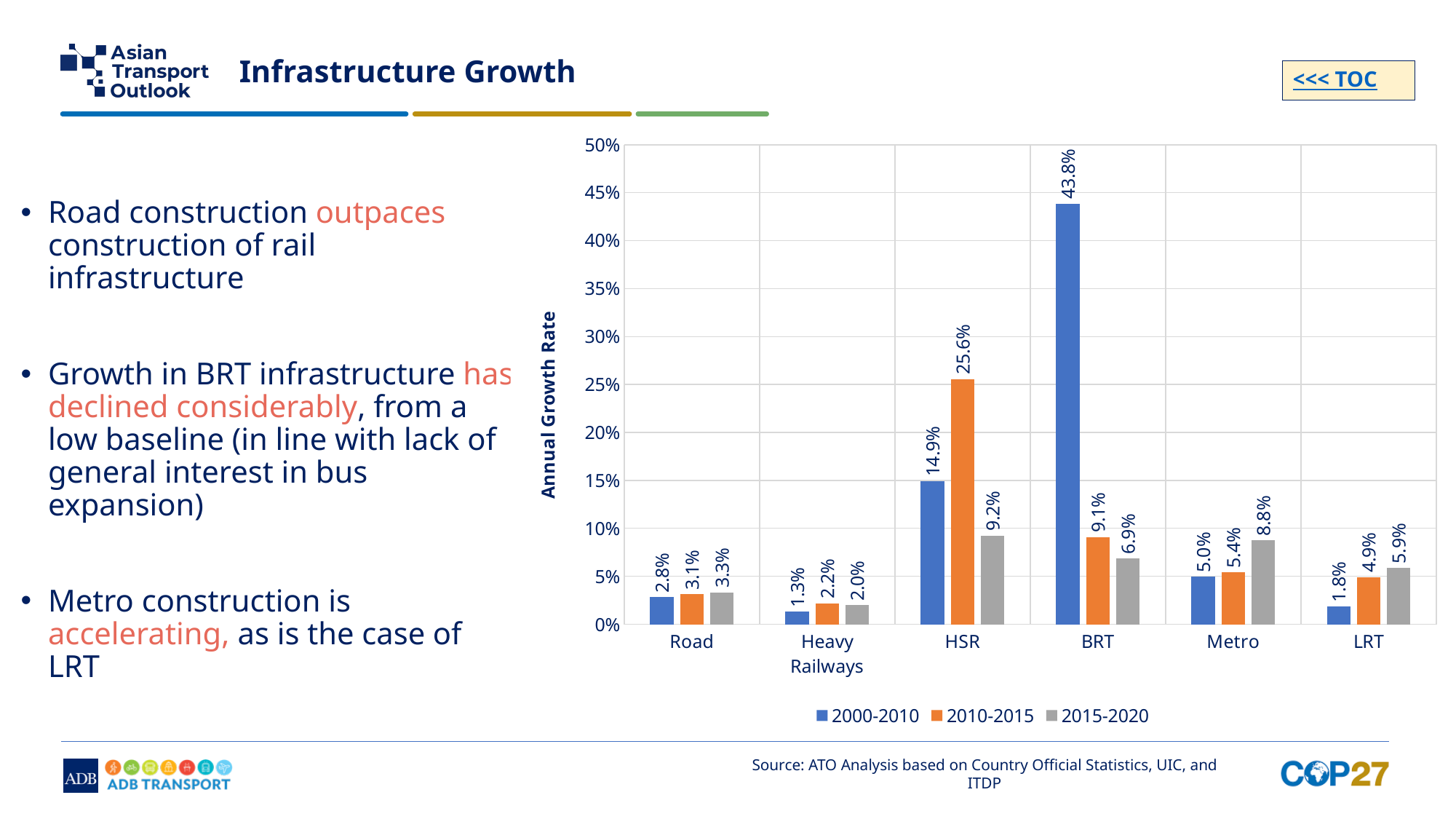
Which is larger, the LRT growth rate in 2010-2015 or the Metro growth rate in 2010-2015? Metro growth rate in 2010-2015 What is the annual growth rate for Metro in 2015-2020? 8.8% What is the label of the vertical axis of the chart? Annual Growth Rate What is the annual growth rate for HSR in 2010-2015? 25.6% What kind of chart is shown on the slide? Bar chart Which category has the lowest annual growth rate in the 2015-2020 series? Heavy Railways What is the difference between the BRT growth rate in 2000-2010 and in 2010-2015? 34.7% How many categories are shown on the x axis of the chart? 6 How many series does the legend list? 3 Which category has the highest annual growth rate in the 2000-2010 series? BRT What is the annual growth rate for Heavy Railways in 2000-2010? 1.3% What is the annual growth rate for BRT in 2000-2010? 43.8%